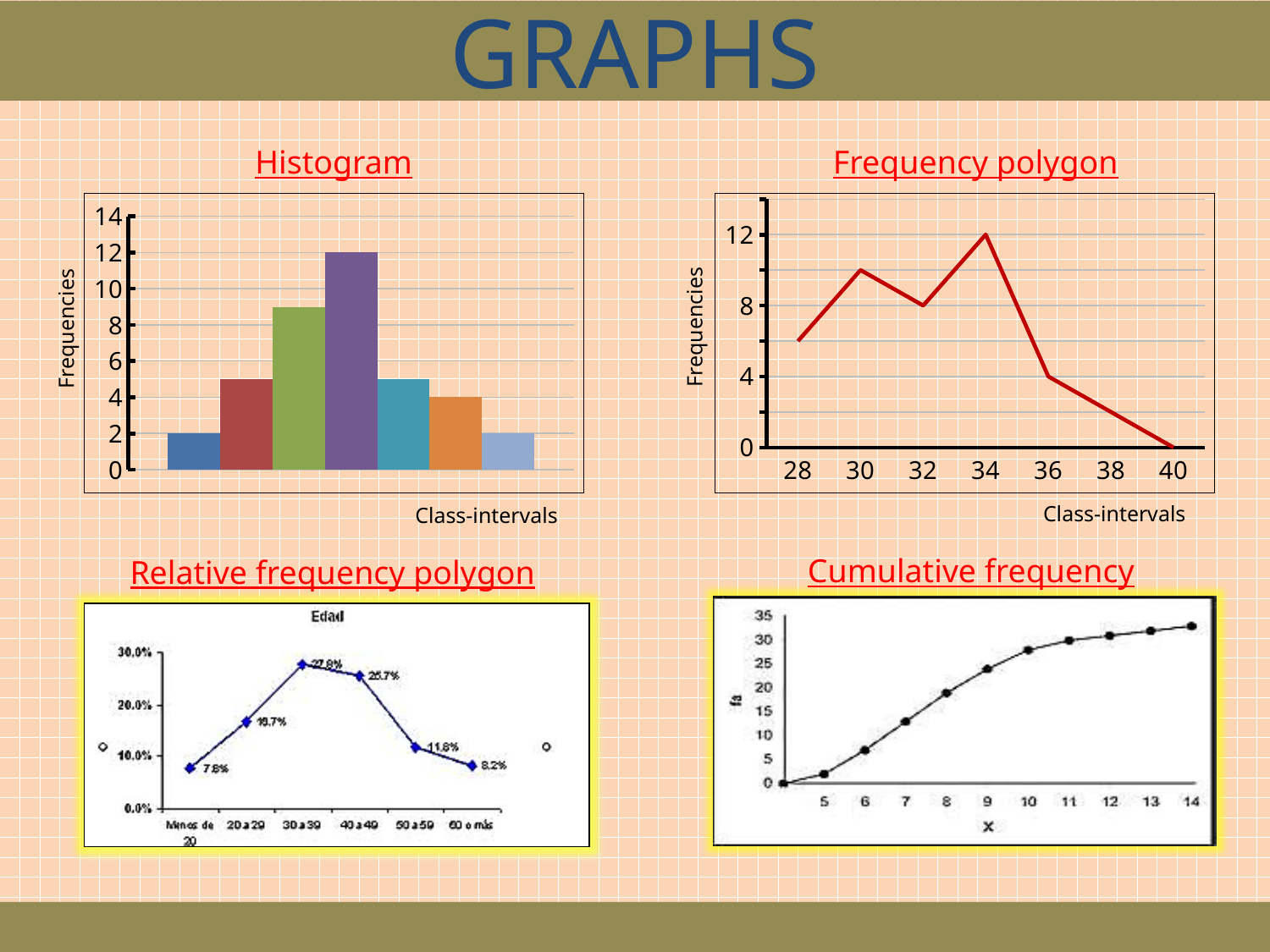
In the Histogram chart, what is the value of the tallest (fourth) bar? 12 In the Histogram chart, how many bars are plotted? 7 In the Frequency polygon chart, what is the frequency at class-interval 34? 12 In the Histogram chart, what kind of chart is shown? bar chart In the Relative frequency polygon chart, what is the difference between the values for 30 a 39 and 40 a 49? 2.1% In the Frequency polygon chart, is the frequency at class-interval 28 greater or less than 8? less In the Cumulative frequency chart, do the values rise or fall as X increases? rise In the Frequency polygon chart, what is the frequency at class-interval 36? 4 In the Relative frequency polygon chart, which category has the lowest value? Menos de 20 In the Relative frequency polygon chart, what is the value for the 30 a 39 category? 27.8% In the Frequency polygon chart, which class-interval has the highest frequency? 34 In the Histogram chart, is the value of the third bar greater or less than 8? greater